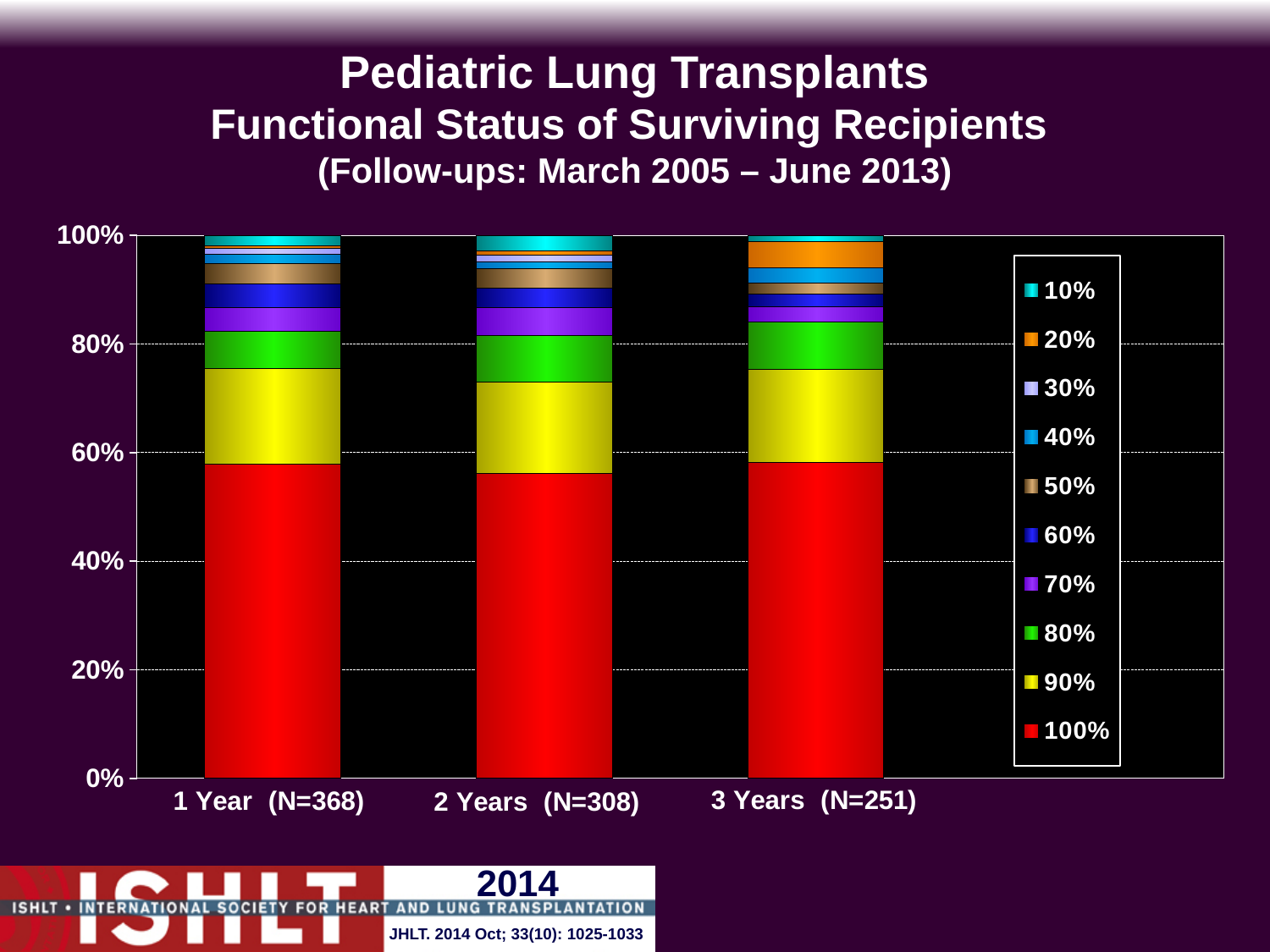
How many follow-up time categories are shown on the x axis? 3 Is the share of the 100% functional status segment in the 3 Years bar greater or less than 40%? greater Which category has the largest N? 1 Year (N=368) Is the share of the 100% functional status segment in the 2 Years bar greater or less than 60%? less Which colour represents the 100% functional status series in the legend? red What is the total height of the stacked bar for 1 Year (N=368)? 100% What kind of chart is shown on the slide? stacked bar chart How many series does the legend list? 10 Which functional status series takes up the largest share of the 1 Year bar? 100% What is the N for the 3 Years category? 251 What is the N for the 2 Years category? 308 What is the title of the chart? Pediatric Lung Transplants Functional Status of Surviving Recipients (Follow-ups: March 2005 – June 2013)